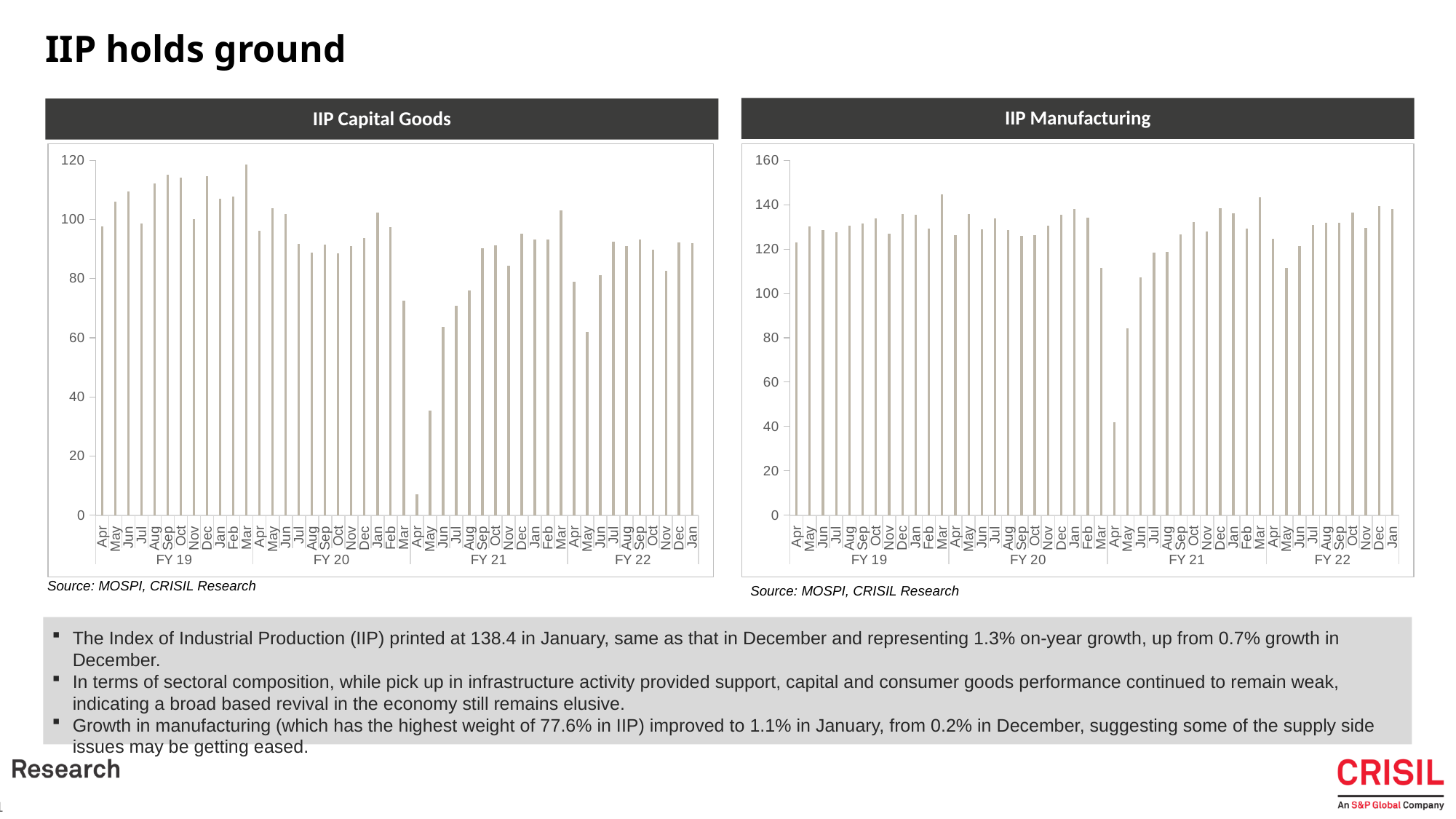
How many monthly bars are plotted in the IIP Manufacturing chart? 46 In the IIP Manufacturing chart, is the value for Jan FY 22 greater or less than 120? greater In the IIP Capital Goods chart, which month has the lowest value? Apr FY 21 In the IIP Capital Goods chart, is the value for Jan FY 22 greater or less than 100? less In the IIP Capital Goods chart, is the value for May FY 21 greater or less than 40? less What source is cited below the IIP Manufacturing chart? MOSPI, CRISIL Research In the IIP Capital Goods chart, which is larger, the value for Mar FY 20 or the value for Apr FY 21? Mar FY 20 In the IIP Manufacturing chart, which month has the lowest value? Apr FY 21 What kind of chart is the IIP Capital Goods chart? bar chart In the IIP Capital Goods chart, which month has the highest value? Mar FY 19